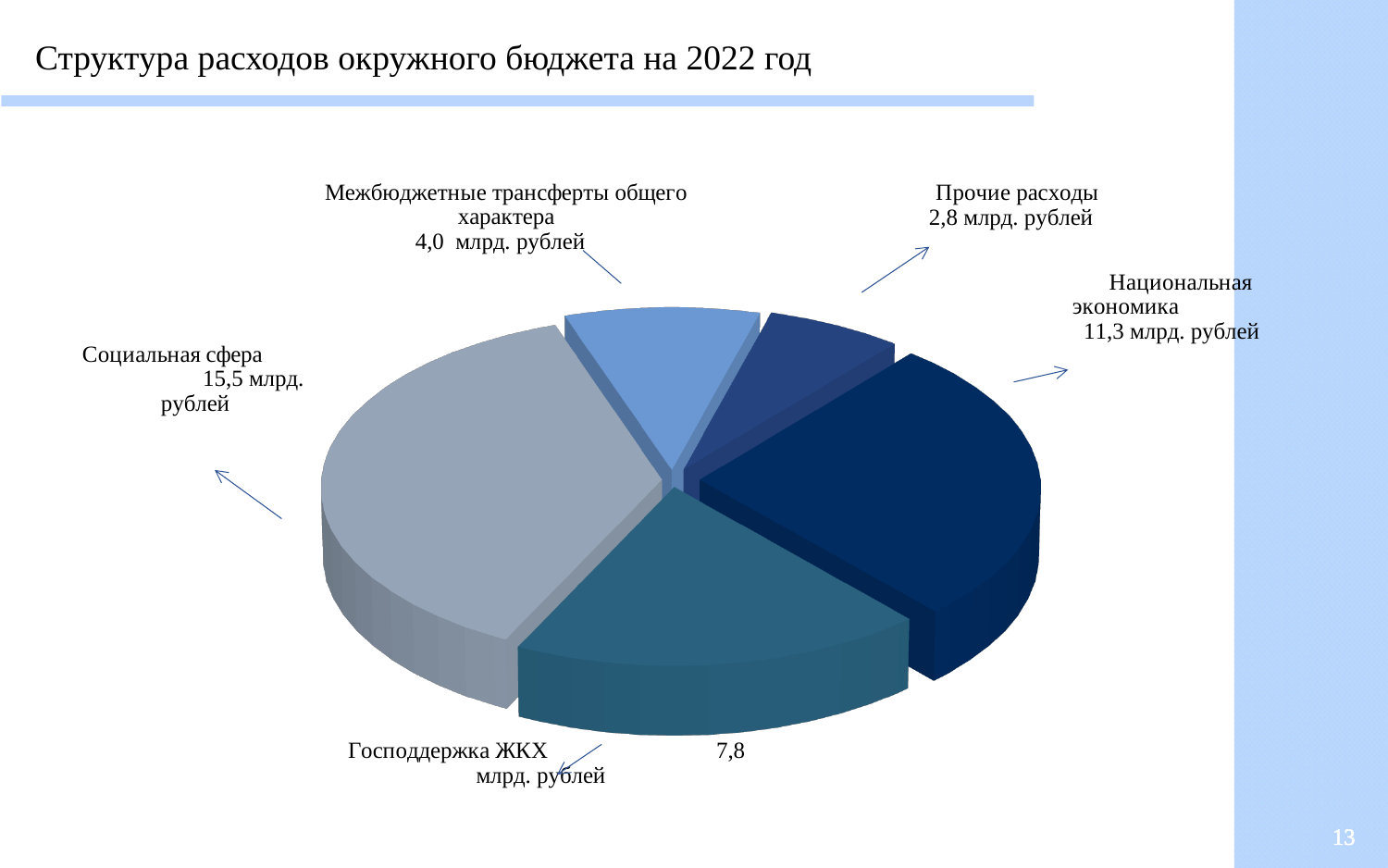
What is the value for Социальная сфера? 15,5 млрд. рублей What is the value for Прочие расходы? 2,8 млрд. рублей How many categories are shown in the pie chart? 5 What is the title of the slide? Структура расходов окружного бюджета на 2022 год Which category has the largest slice of the pie? Социальная сфера What is the value for Межбюджетные трансферты общего характера? 4,0 млрд. рублей What is the value for Господдержка ЖКХ? 7,8 млрд. рублей Which is larger, Господдержка ЖКХ or Межбюджетные трансферты общего характера? Господдержка ЖКХ What is the difference between Социальная сфера and Национальная экономика? 4,2 млрд. рублей What is the value for Национальная экономика? 11,3 млрд. рублей What kind of chart is shown on the slide? Pie chart Which category has the smallest slice of the pie? Прочие расходы